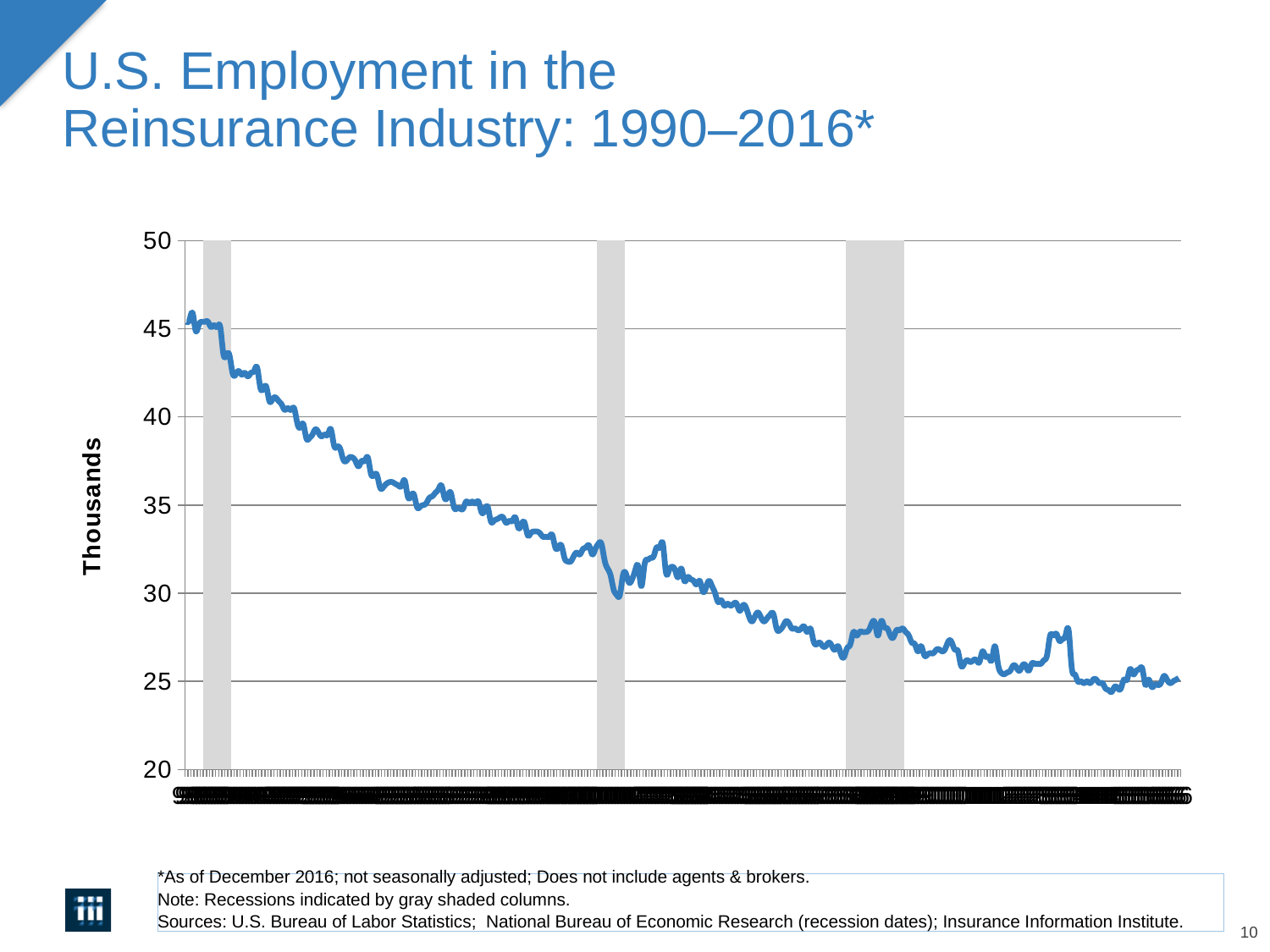
Which is larger, the value at the start of the series or the value at the end of the series? the value at the start What is the lowest tick value shown on the vertical axis? 20 What kind of chart is shown on the slide? line chart Do the values in the chart generally rise or fall from left to right along the x axis? fall What is the highest tick value shown on the vertical axis? 50 Is the value at the start of the series (1990) greater or less than 40? greater Is the value at the end of the series (2016) greater or less than 20? greater Is the value at the end of the series (2016) greater or less than 30? less What is the label on the vertical axis of the chart? Thousands How many gray shaded recession columns are shown on the chart? 3